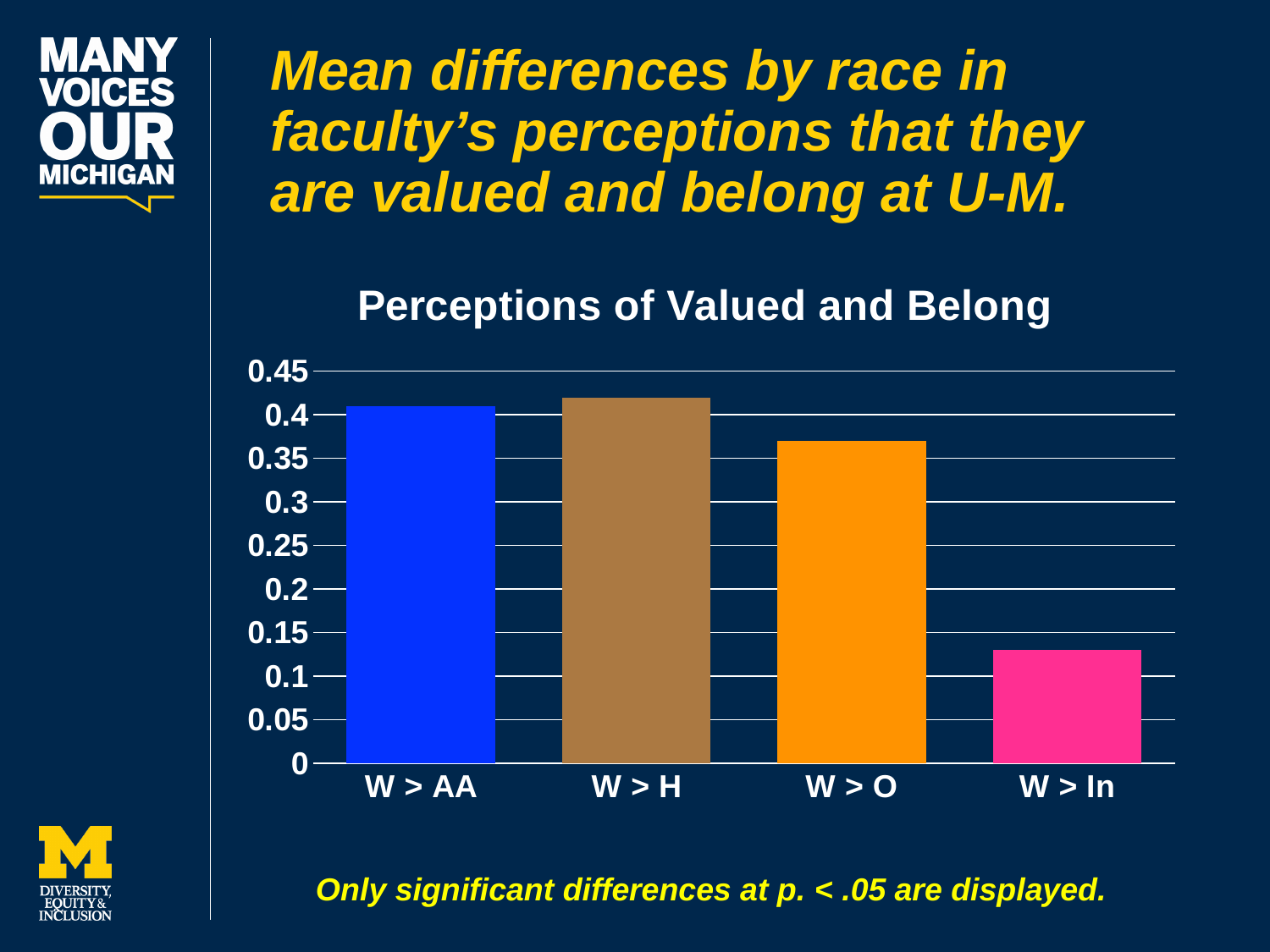
What is the title of the chart? Perceptions of Valued and Belong What kind of chart is shown on the slide? bar chart Which is larger, the value for W > O or the value for W > In? W > O Is the value for W > O greater or less than 0.4? less Which is larger, the value for W > AA or the value for W > O? W > AA Which category has the lowest value in the chart? W > In What colour is the bar for W > In? pink How many categories are shown on the x axis of the chart? 4 Is the value for W > In greater or less than 0.1? greater Is the value for W > In greater or less than 0.15? less